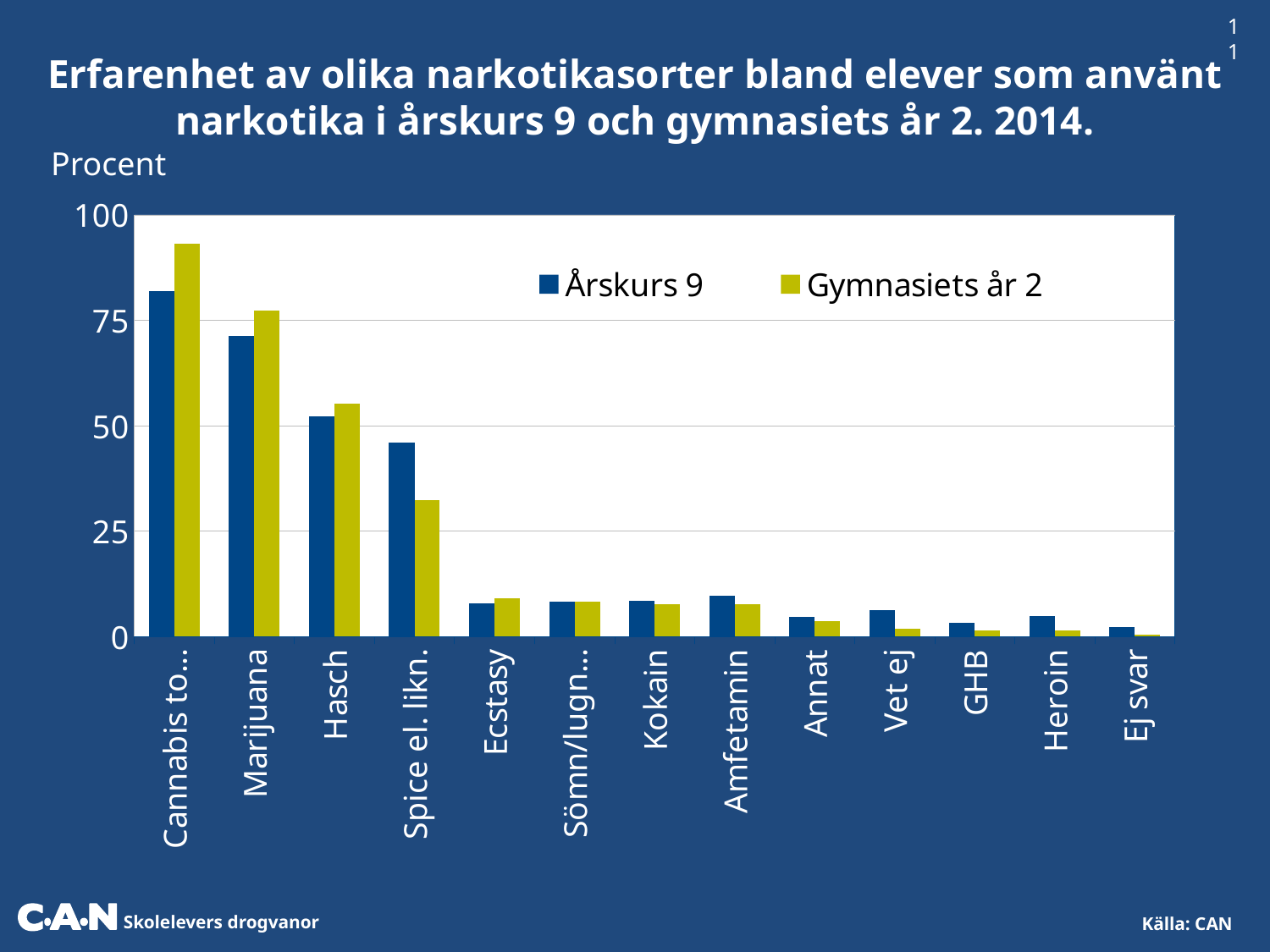
What kind of chart is shown on the slide? bar chart Do the values generally rise or fall moving from left to right along the x axis? fall For Spice el. likn., which series has the larger value, Årskurs 9 or Gymnasiets år 2? Årskurs 9 For Marijuana, which series has the larger value, Årskurs 9 or Gymnasiets år 2? Gymnasiets år 2 Is the Årskurs 9 value for Spice el. likn. greater or less than 50? less Which category has the highest value for Gymnasiets år 2? Cannabis to... Which category has the highest value for Årskurs 9? Cannabis to... How many categories are shown on the x axis? 13 Is the Gymnasiets år 2 value for Cannabis greater or less than 75? greater What are the two series named in the legend? Årskurs 9 and Gymnasiets år 2 Is the Gymnasiets år 2 value for Spice el. likn. greater or less than 25? greater How many series does the legend list? 2